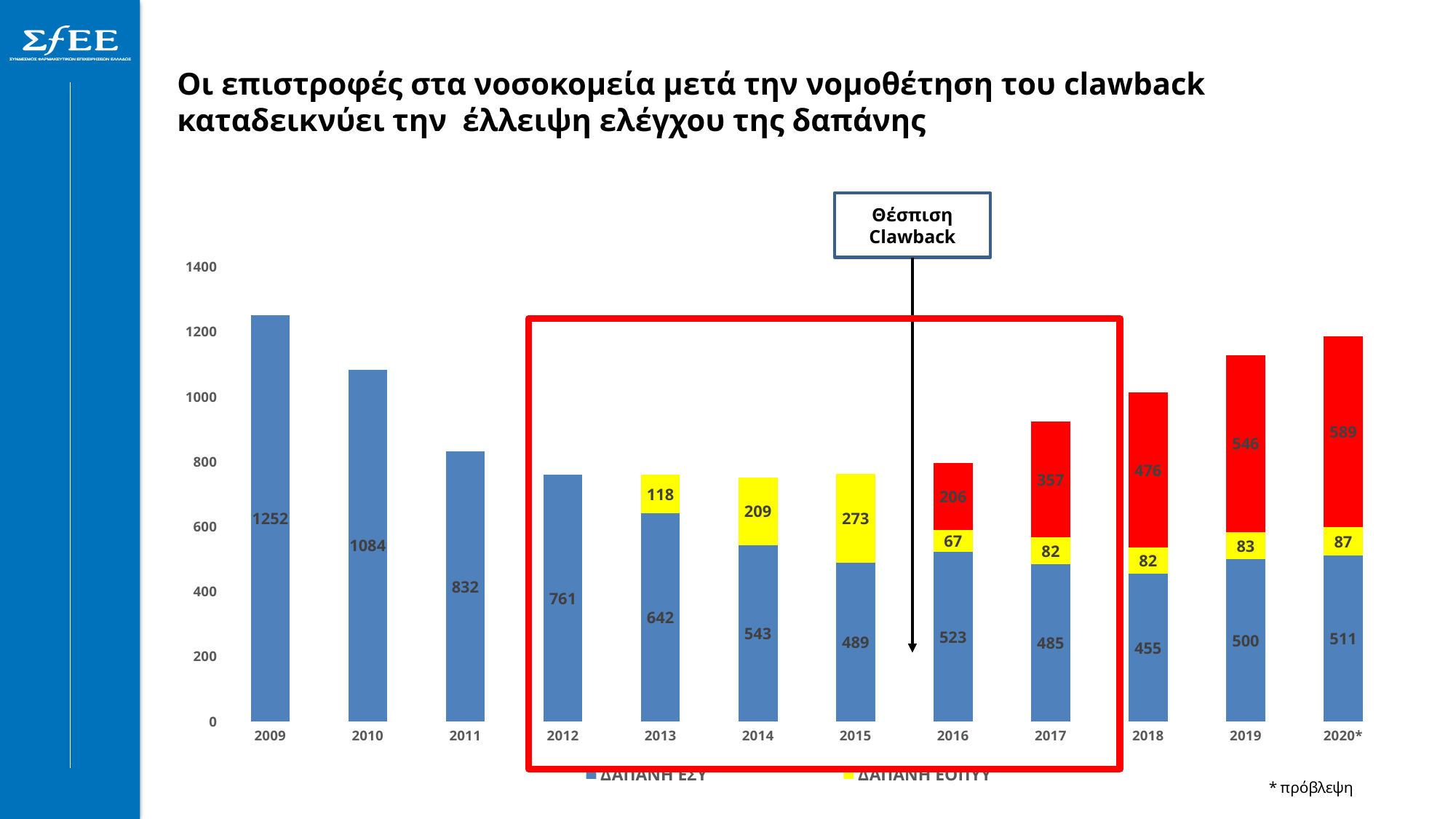
Which year has the lowest value for the blue ΔΑΠΑΝΗ ΕΣΥ segment? 2018 What is the value of the red segment for 2020*? 589 What is the difference between the red segment values for 2019 and 2018? 70 What kind of chart is shown on the slide? Stacked bar chart Which year has the larger red segment, 2016 or 2017? 2017 How many years are shown on the x axis? 12 What is the value of the yellow segment for 2015? 273 Is the total of the stacked bar for 2019 greater or less than 1000? greater What is the total of the stacked bar for 2013? 760 What is the value of the blue ΔΑΠΑΝΗ ΕΣΥ segment for 2009? 1252 Which year has the highest value for the blue ΔΑΠΑΝΗ ΕΣΥ segment? 2009 What is the total of the stacked bar for 2017? 924